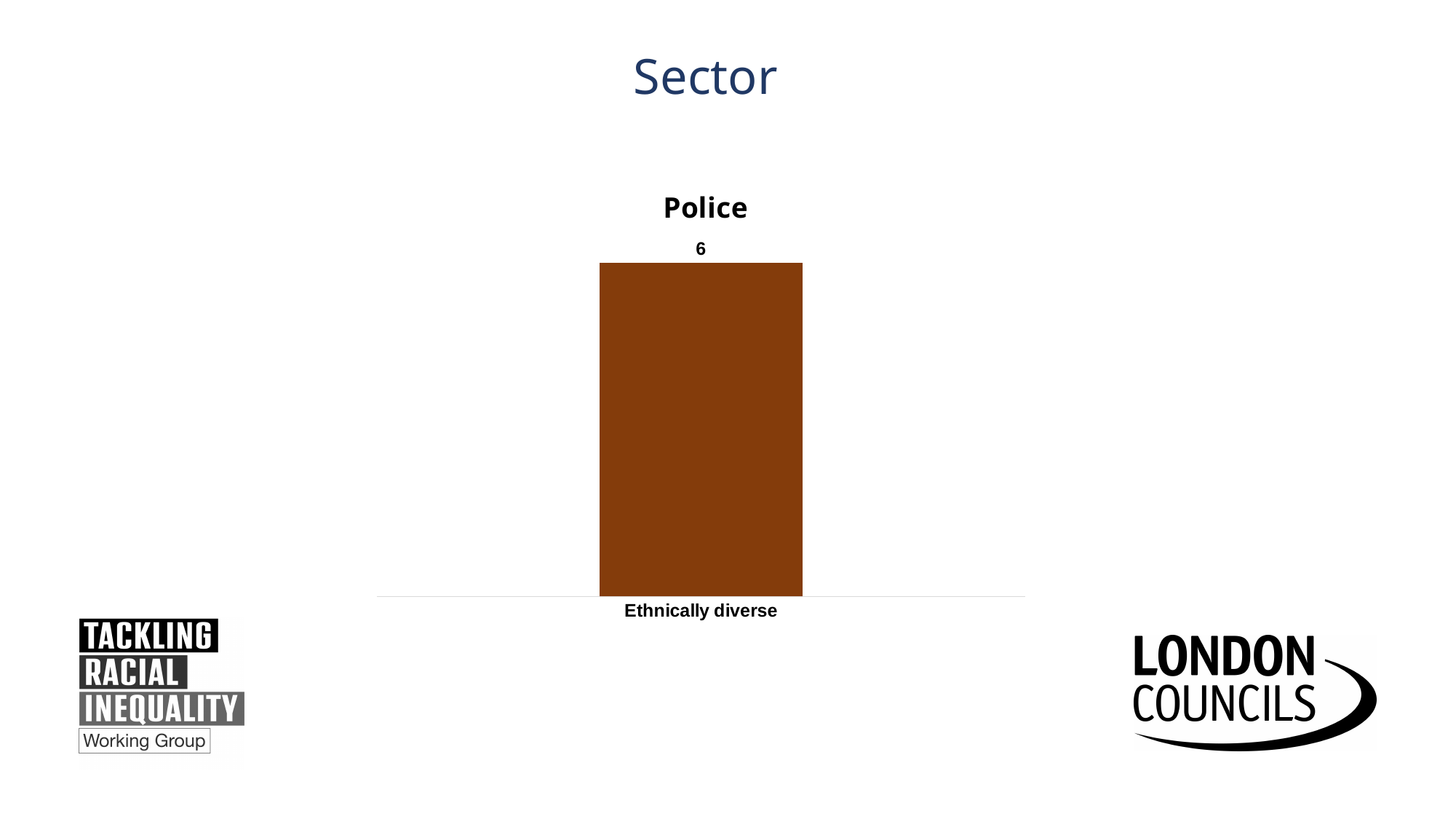
What is the title of the chart on the slide? Police What kind of chart is shown on the slide? bar chart How many categories are plotted in the Police chart? 1 Is the value for Ethnically diverse in the Police chart greater or less than 10? less What is the label of the single category on the x axis of the Police chart? Ethnically diverse What is the value for Ethnically diverse in the Police chart? 6 Is the value for Ethnically diverse in the Police chart greater or less than 5? greater